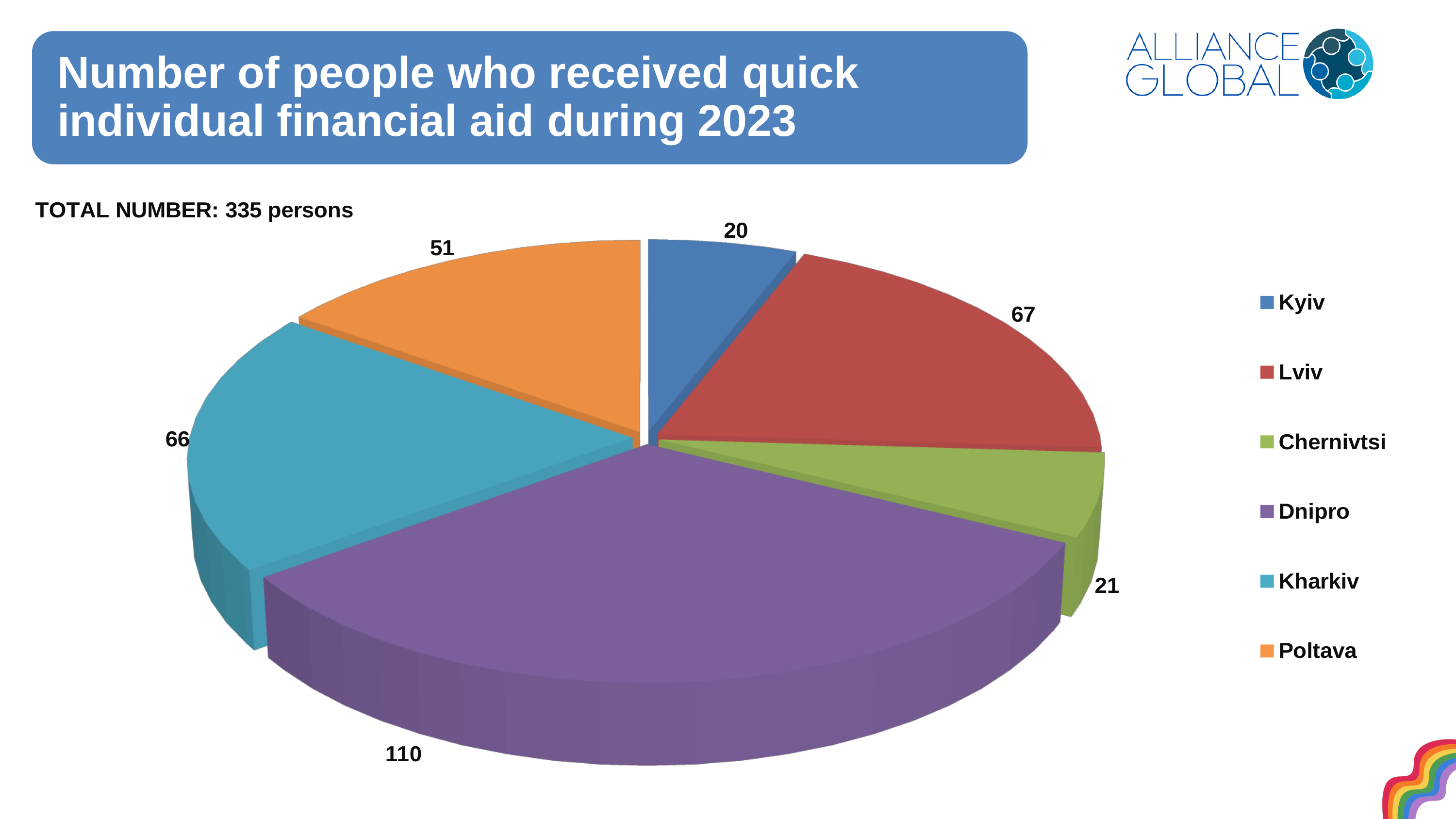
What kind of chart is shown on the slide? pie chart Which city has the largest slice of the pie? Dnipro Which city has the smallest slice of the pie? Kyiv How many cities are shown in the pie chart? 6 What is the value shown for Poltava? 51 What is the difference between the values for Dnipro and Kharkiv? 44 What is the value shown for Kharkiv? 66 Which is larger, the value for Poltava or the value for Chernivtsi? Poltava What is the difference between the values for Lviv and Kyiv? 47 How many people in Dnipro received quick individual financial aid during 2023? 110 What total number of persons is stated on the slide? 335 persons What is the value shown for Lviv? 67